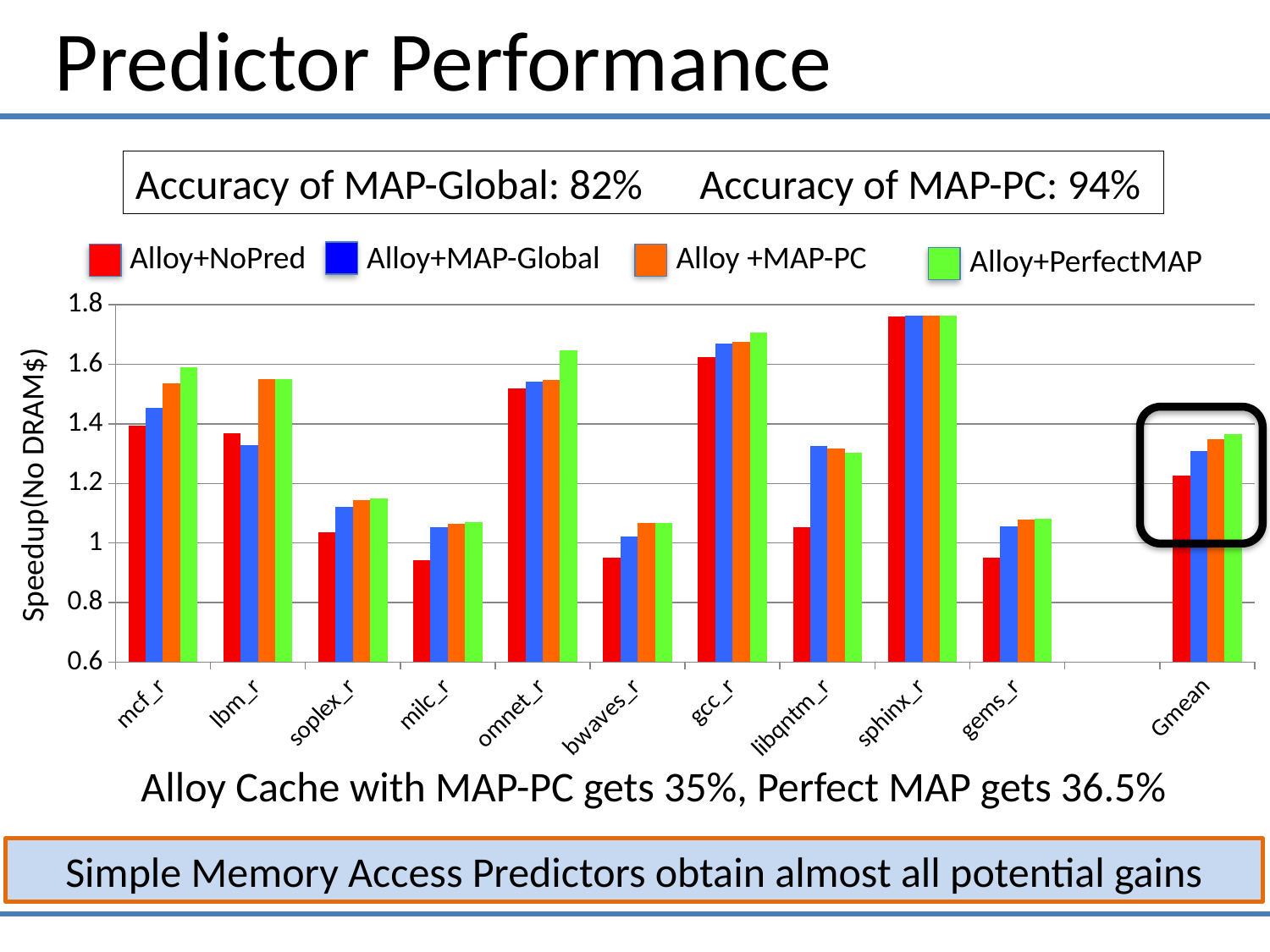
Is the Alloy+NoPred value for soplex_r greater or less than 1? greater Is the Alloy+MAP-Global value for libqntm_r greater or less than 1.2? greater How many series does the legend list? 4 For mcf_r, which is larger: Alloy+NoPred or Alloy+PerfectMAP? Alloy+PerfectMAP Which category has the highest speedup for Alloy+PerfectMAP? sphinx_r What kind of chart is shown on the slide? bar chart How many benchmark categories are shown on the x axis (including Gmean)? 11 Is the Alloy+PerfectMAP value for omnet_r greater or less than 1.6? greater What is the label of the y axis? Speedup(No DRAM$) For libqntm_r, which is larger: Alloy+NoPred or Alloy+MAP-Global? Alloy+MAP-Global Which colour represents Alloy+PerfectMAP in the legend? green